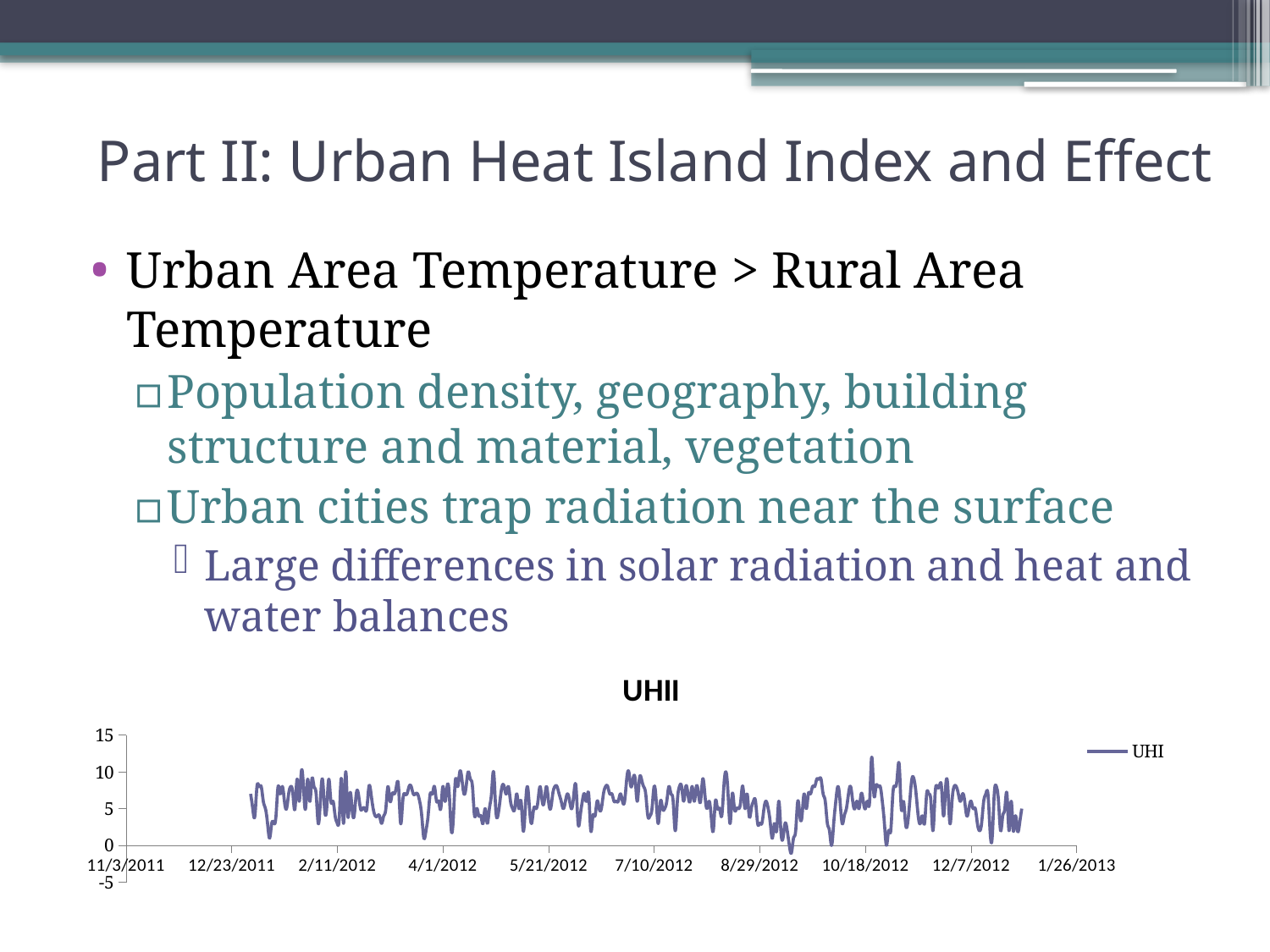
Is the highest value reached by the UHI series greater or less than 10? greater Is the lowest value reached by the UHI series greater or less than -5? greater Is the highest value reached by the UHI series greater or less than 15? less What kind of chart is shown on the slide? line chart What is the last date label on the chart's horizontal axis? 1/26/2013 How many date labels are shown on the chart's horizontal axis? 10 What is the first date label on the chart's horizontal axis? 11/3/2011 What is the name of the series shown in the chart's legend? UHI What is the title of the chart? UHII How many series does the chart's legend list? 1 What is the highest value shown on the chart's vertical axis? 15 What is the lowest value shown on the chart's vertical axis? -5